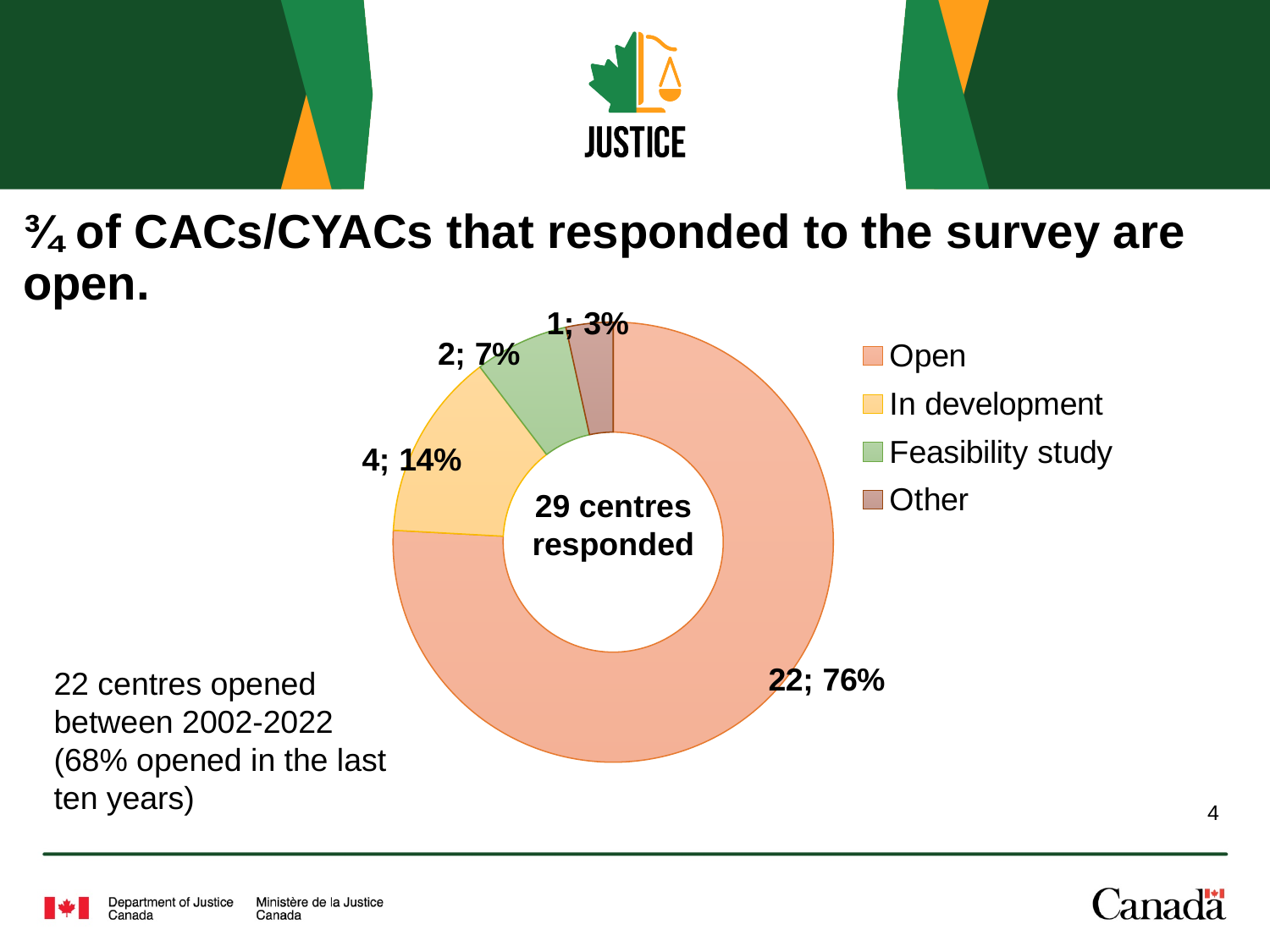
How many centres are labelled as Open? 22 Which category has the smallest slice? Other Which is larger, the In development slice or the Feasibility study slice? In development How many more centres are Open than In development? 18 What text appears in the centre of the doughnut chart? 29 centres responded What percentage share does the Other slice have? 3% Which category has the largest slice? Open What kind of chart is shown on the slide? Doughnut (pie) chart What colour is the Open slice? Orange (peach) What percentage of centres are In development? 14% How many centres are in the Feasibility study category? 2 How many categories does the legend list? 4